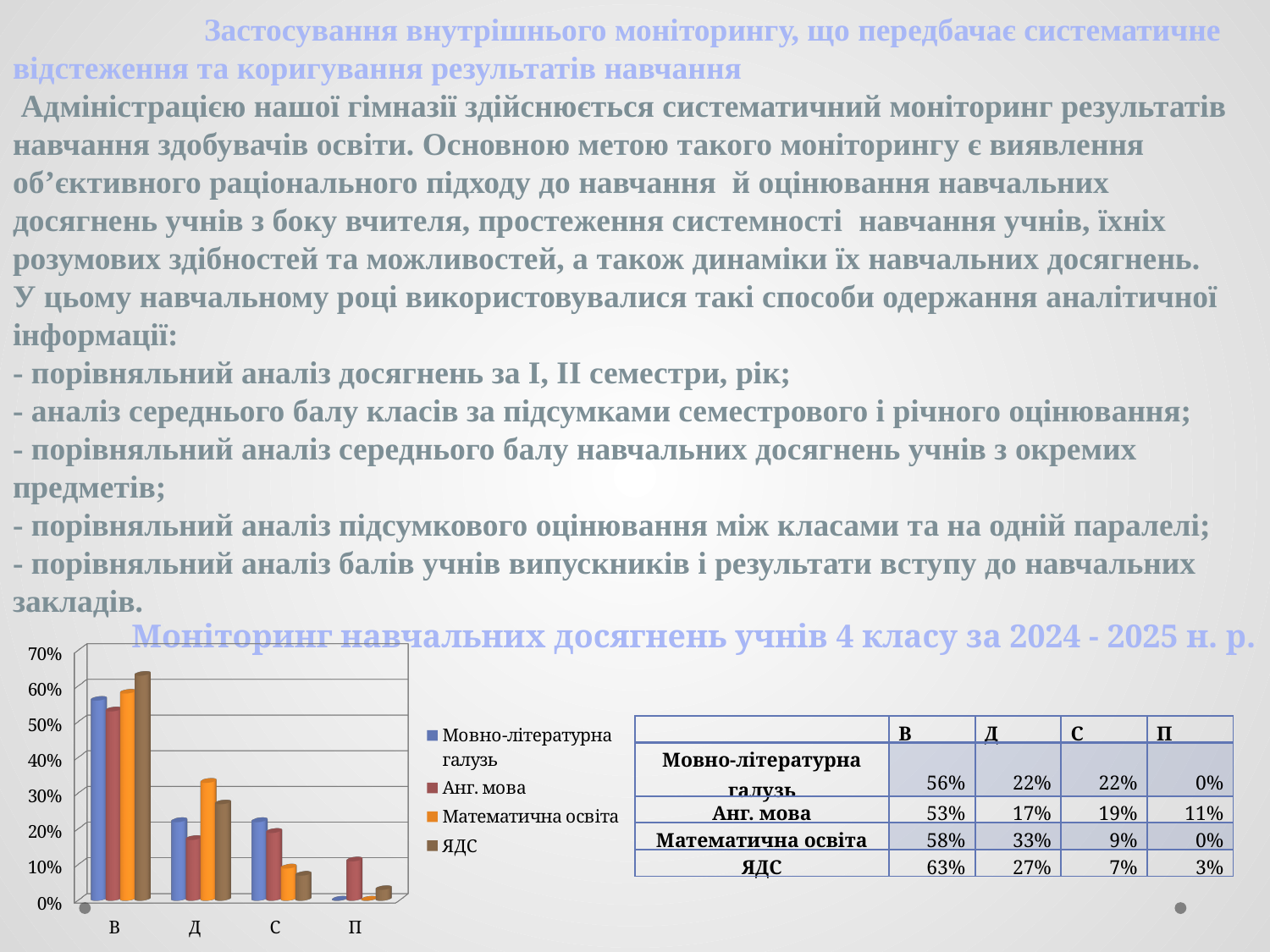
Do the values for Математична освіта rise or fall from category В to category П? fall Is the value for ЯДС in category В greater or less than 60%? greater According to the slide, what is the value for ЯДС in category В? 63% How many categories are shown on the x axis of the chart? 4 Which series has the highest value in category В? ЯДС What kind of chart is shown on the slide? bar chart Which is larger in category Д: Мовно-літературна галузь or Анг. мова? Мовно-літературна галузь According to the slide, what is the value for Анг. мова in category П? 11% How many series does the chart legend list? 4 According to the slide, what is the value for Математична освіта in category Д? 33% Which series has the lowest value in category С? ЯДС What is the difference between the Математична освіта value in category В and in category Д? 25%